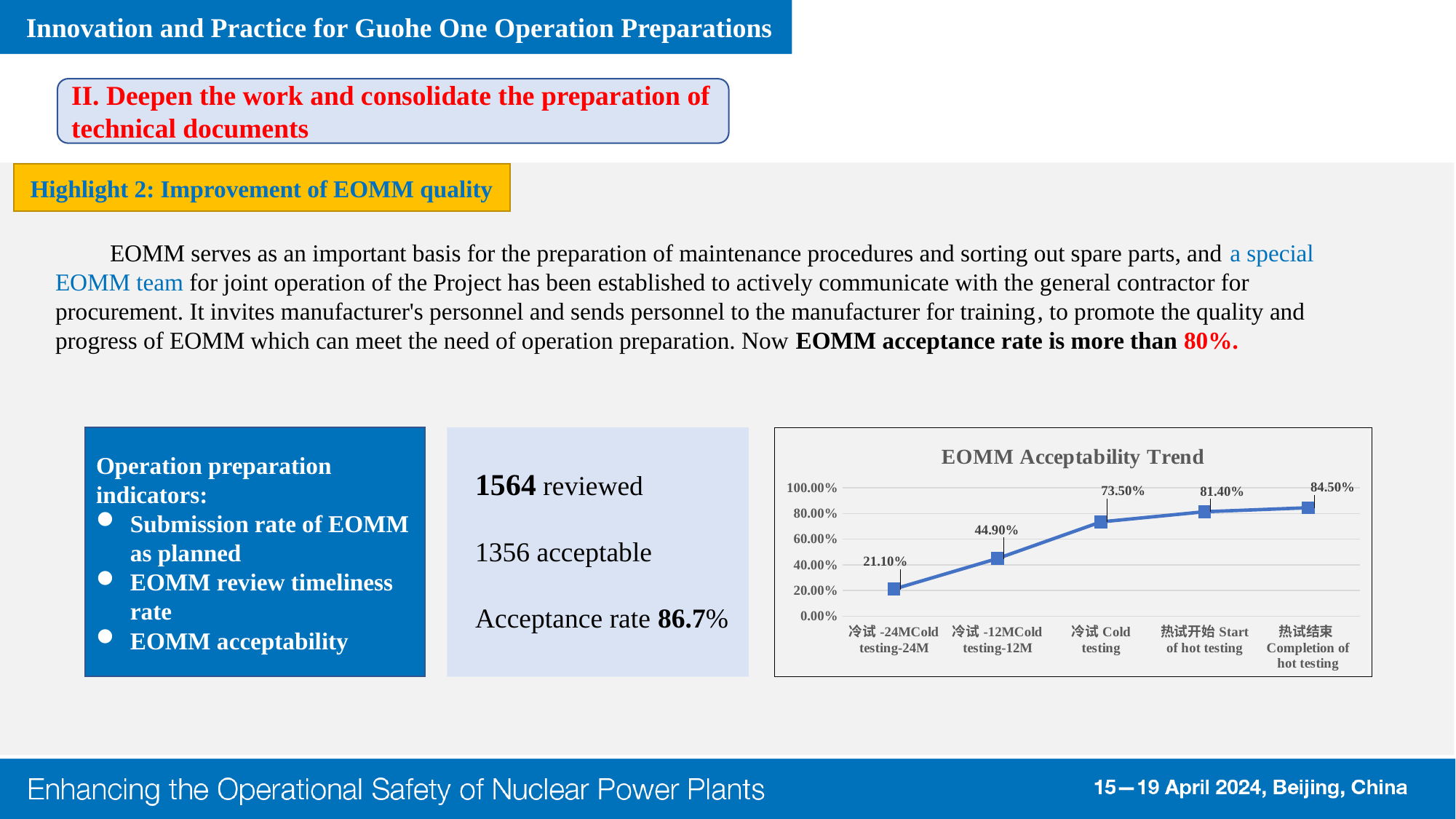
Do the EOMM acceptability values rise or fall from Cold testing-24M to Completion of hot testing? rise What is the EOMM acceptability value at Cold testing? 73.50% What is the EOMM acceptability value at Start of hot testing? 81.40% Which stage has the highest EOMM acceptability value? Completion of hot testing How many data points are plotted on the EOMM Acceptability Trend chart? 5 What is the EOMM acceptability value at Cold testing-12M? 44.90% What is the EOMM acceptability value at Cold testing-24M? 21.10% What type of chart is shown on the slide? line chart What is the title of the chart on the slide? EOMM Acceptability Trend What is the EOMM acceptability value at Completion of hot testing? 84.50% Which stage has the lowest EOMM acceptability value? Cold testing-24M What is the difference between the EOMM acceptability values at Cold testing and Cold testing-12M? 28.60%